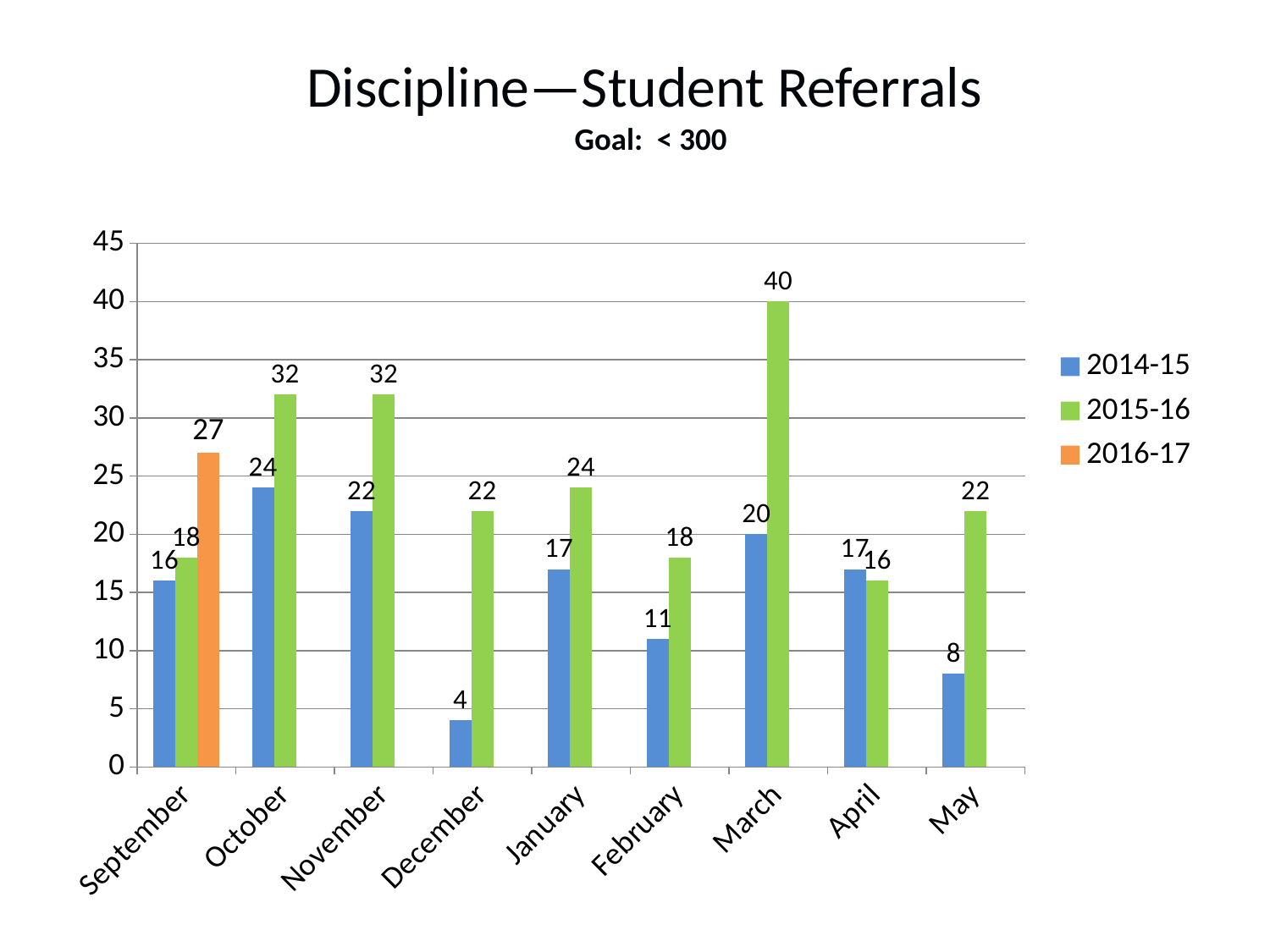
What is the value for 2016-17 in September? 27 What kind of chart is shown on the slide? Bar chart How many months are shown on the x axis? 9 What goal is stated under the chart title? < 300 How many series does the legend list? 3 In April, which series has the larger value, 2014-15 or 2015-16? 2014-15 What is the value for 2015-16 in March? 40 Which month has the highest value for the 2015-16 series? March What is the difference between the 2015-16 and 2014-15 values in May? 14 Which month has the lowest value for the 2014-15 series? December What is the value for 2014-15 in December? 4 What is the title of the chart? Discipline—Student Referrals